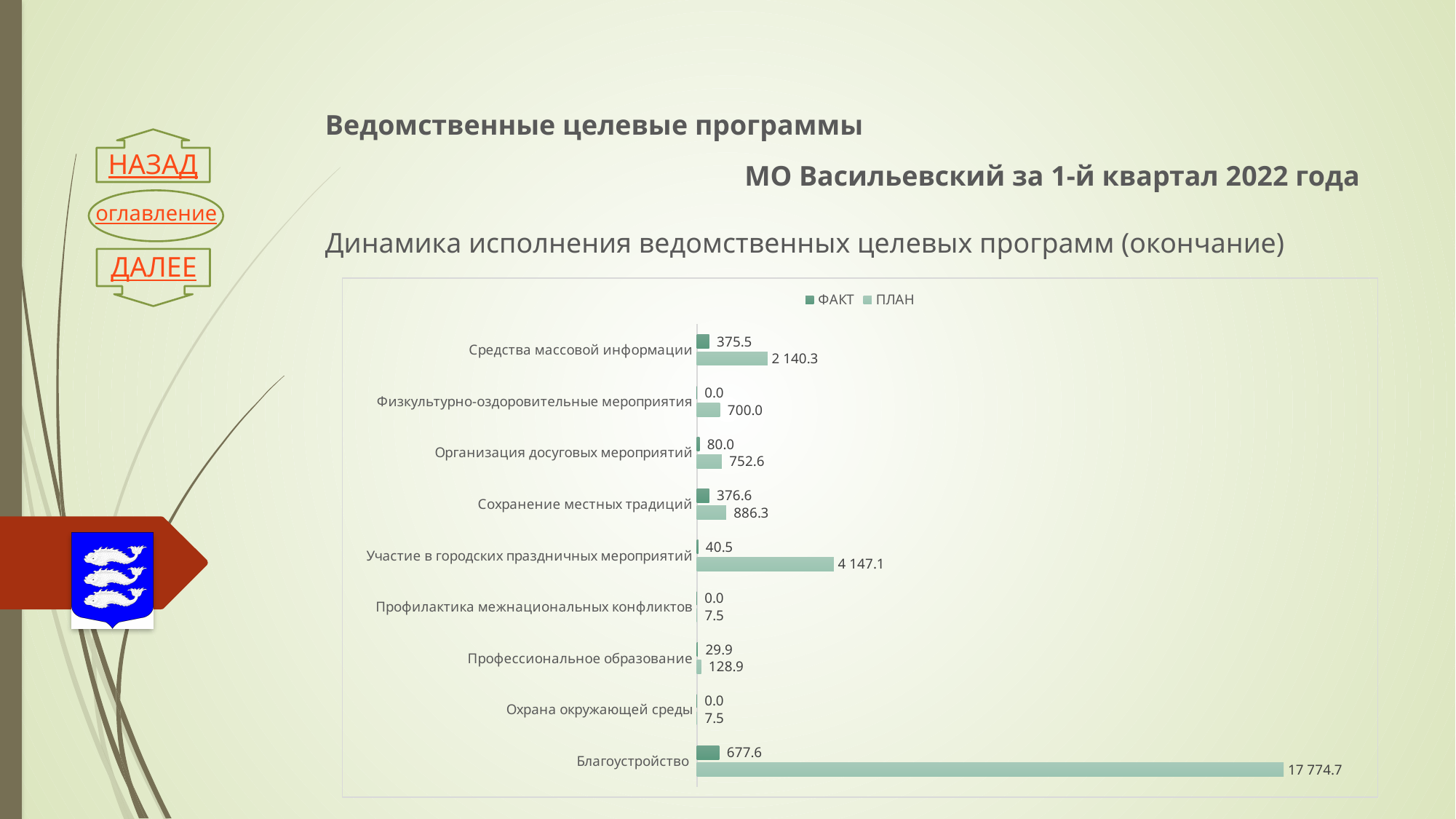
What is the ФАКТ value for Профессиональное образование? 29.9 How many series does the legend list? 2 Which is larger: the ПЛАН value for Физкультурно-оздоровительные мероприятия or for Организация досуговых мероприятий? Организация досуговых мероприятий How many categories are shown in the chart? 9 What is the ПЛАН value for Благоустройство? 17 774.7 What are the two series named in the legend? ФАКТ and ПЛАН Which category has the highest ПЛАН value? Благоустройство What is the ПЛАН value for Участие в городских праздничных мероприятий? 4 147.1 What type of chart is shown on the slide? bar chart What is the ФАКТ value for Средства массовой информации? 375.5 Which category has the highest ФАКТ value? Благоустройство What is the difference between the ПЛАН and ФАКТ values for Благоустройство? 17 097.1